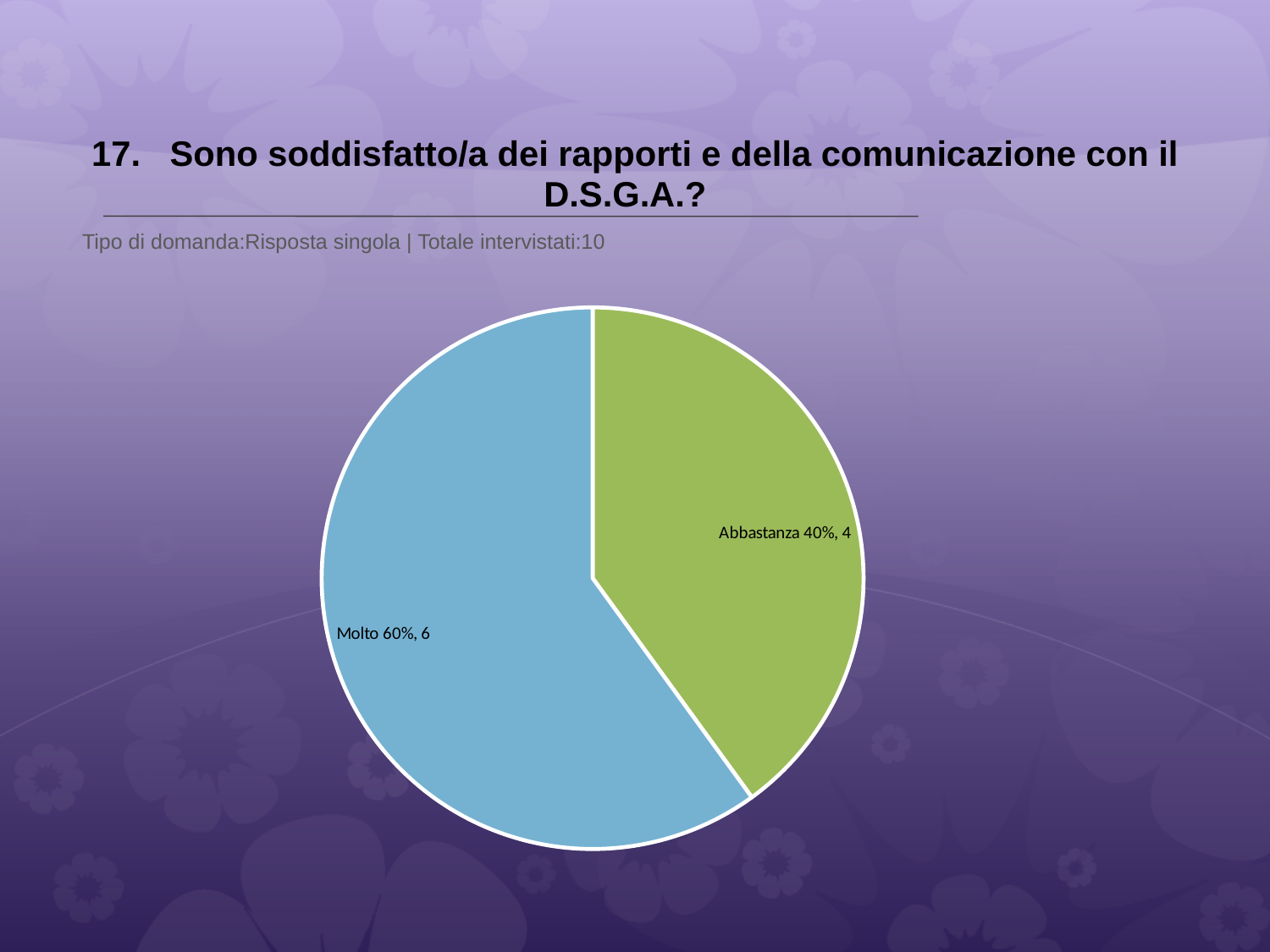
Which has more respondents, "Molto" or "Abbastanza"? Molto Which slice is the smallest in the pie chart? Abbastanza What is the difference in respondent count between "Molto" and "Abbastanza"? 2 What kind of chart is shown on the slide? pie chart How many respondents answered "Abbastanza"? 4 What percentage share does the "Molto" slice have? 60% How many respondents answered "Molto"? 6 How many slices does the pie chart have? 2 Which slice is the largest in the pie chart? Molto What percentage share does the "Abbastanza" slice have? 40% What colour is the "Abbastanza" slice? green What is the total number of respondents shown in the pie chart? 10